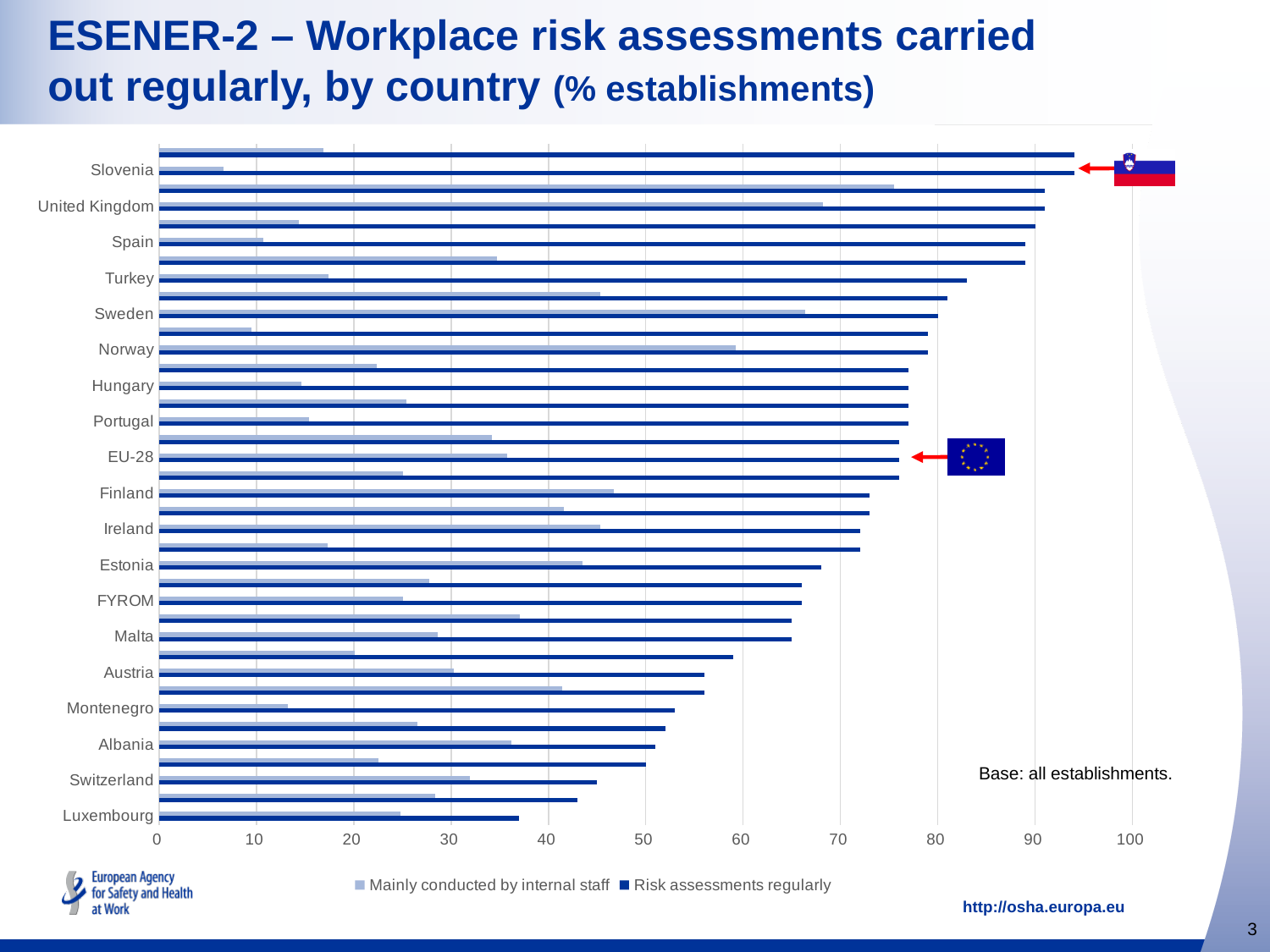
How many series does the legend list? 2 Which country has the highest value for 'Risk assessments regularly'? Slovenia Is the 'Risk assessments regularly' value for Luxembourg greater or less than 40? less What kind of chart is shown on the slide? Bar chart What are the two legend entries of the chart? Mainly conducted by internal staff; Risk assessments regularly Is the 'Mainly conducted by internal staff' value for Slovenia greater or less than 10? less Which has a larger 'Risk assessments regularly' value, Spain or Austria? Spain Do the 'Risk assessments regularly' values rise or fall going from the top of the chart to the bottom? fall Is the 'Risk assessments regularly' value for EU-28 greater or less than 70? greater Which labelled country has the lowest value for 'Risk assessments regularly'? Luxembourg